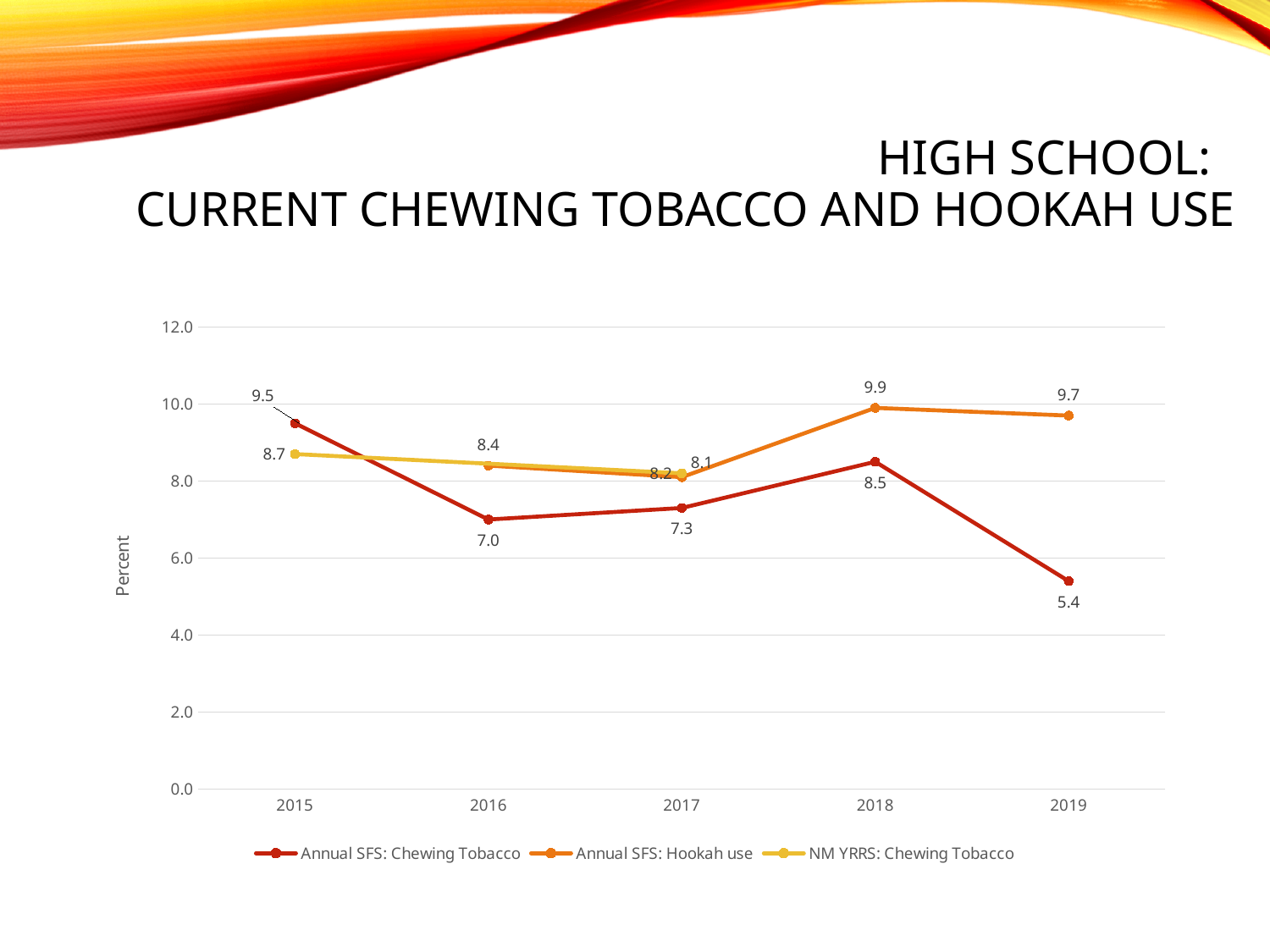
What is the Annual SFS: Chewing Tobacco value for 2019? 5.4 What kind of chart is shown on the slide? line chart How many years are shown on the x axis? 5 What is the NM YRRS: Chewing Tobacco value for 2015? 8.7 Does the Annual SFS: Chewing Tobacco value rise or fall from 2018 to 2019? fall What is the difference between the Annual SFS: Chewing Tobacco values for 2018 and 2019? 3.1 How many series does the legend list? 3 In which year is the Annual SFS: Chewing Tobacco value lowest? 2019 In 2018, which series has the larger value: Annual SFS: Hookah use or Annual SFS: Chewing Tobacco? Annual SFS: Hookah use Is the Annual SFS: Chewing Tobacco value for 2019 greater or less than 6.0? less In which year is the Annual SFS: Chewing Tobacco value highest? 2015 What is the Annual SFS: Hookah use value for 2018? 9.9